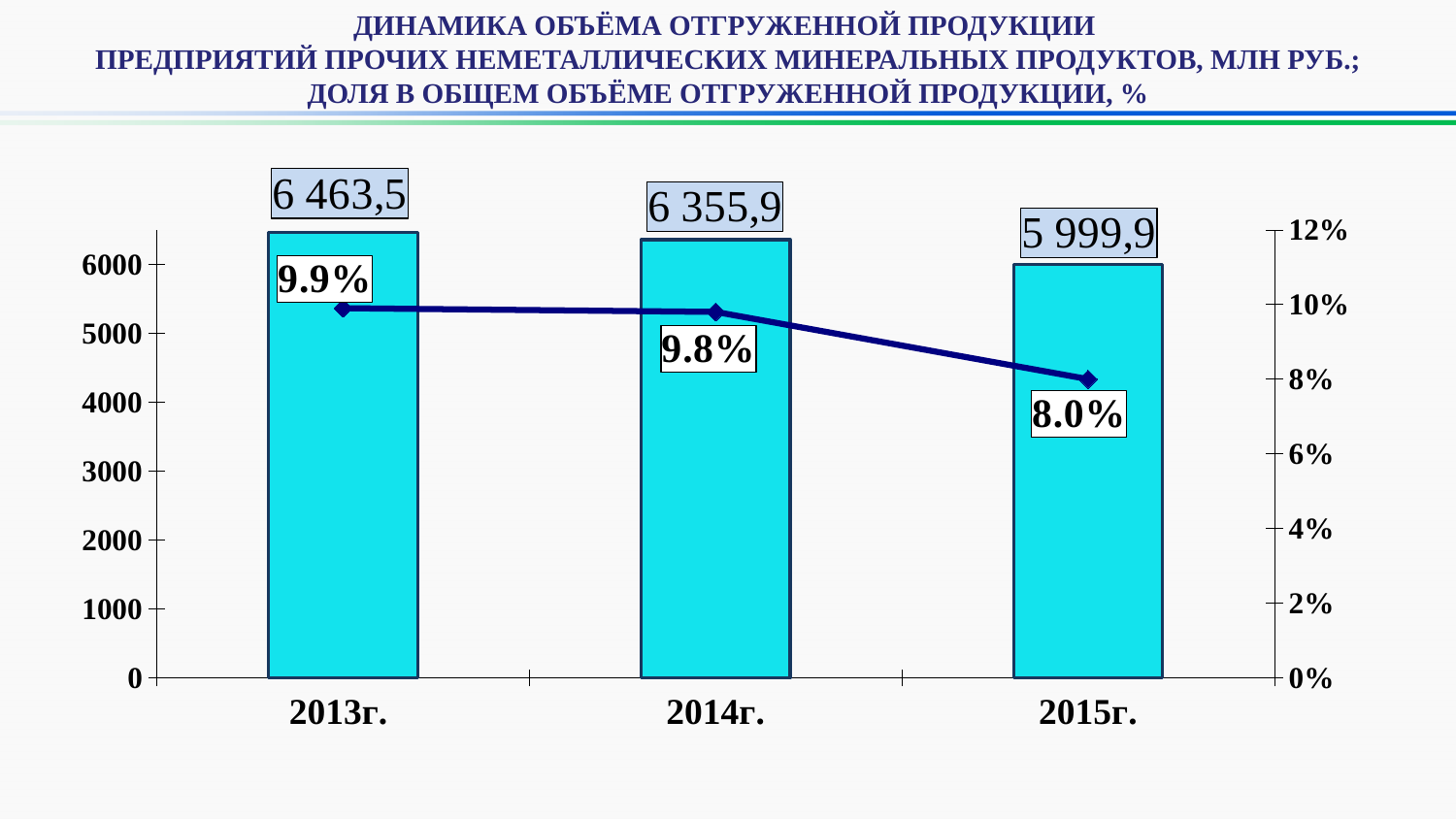
How many years are shown on the x axis? 3 Does the shipped volume rise or fall from 2013г. to 2015г.? Fall Which is larger, the shipped volume in 2013г. or in 2014г.? 2013г. What is the difference in shipped volume between 2014г. and 2015г.? 356,0 What is the share in total shipped products for 2015г.? 8.0% Which year has the lowest share in total shipped products? 2015г. Which year has the highest volume of shipped products? 2013г. What is the share in total shipped products for 2014г.? 9.8% What kind of chart is this? Combined bar and line chart By how many percentage points did the share fall from 2013г. to 2015г.? 1.9% What is the volume of shipped products for 2013г.? 6 463,5 What is the volume of shipped products for 2015г.? 5 999,9